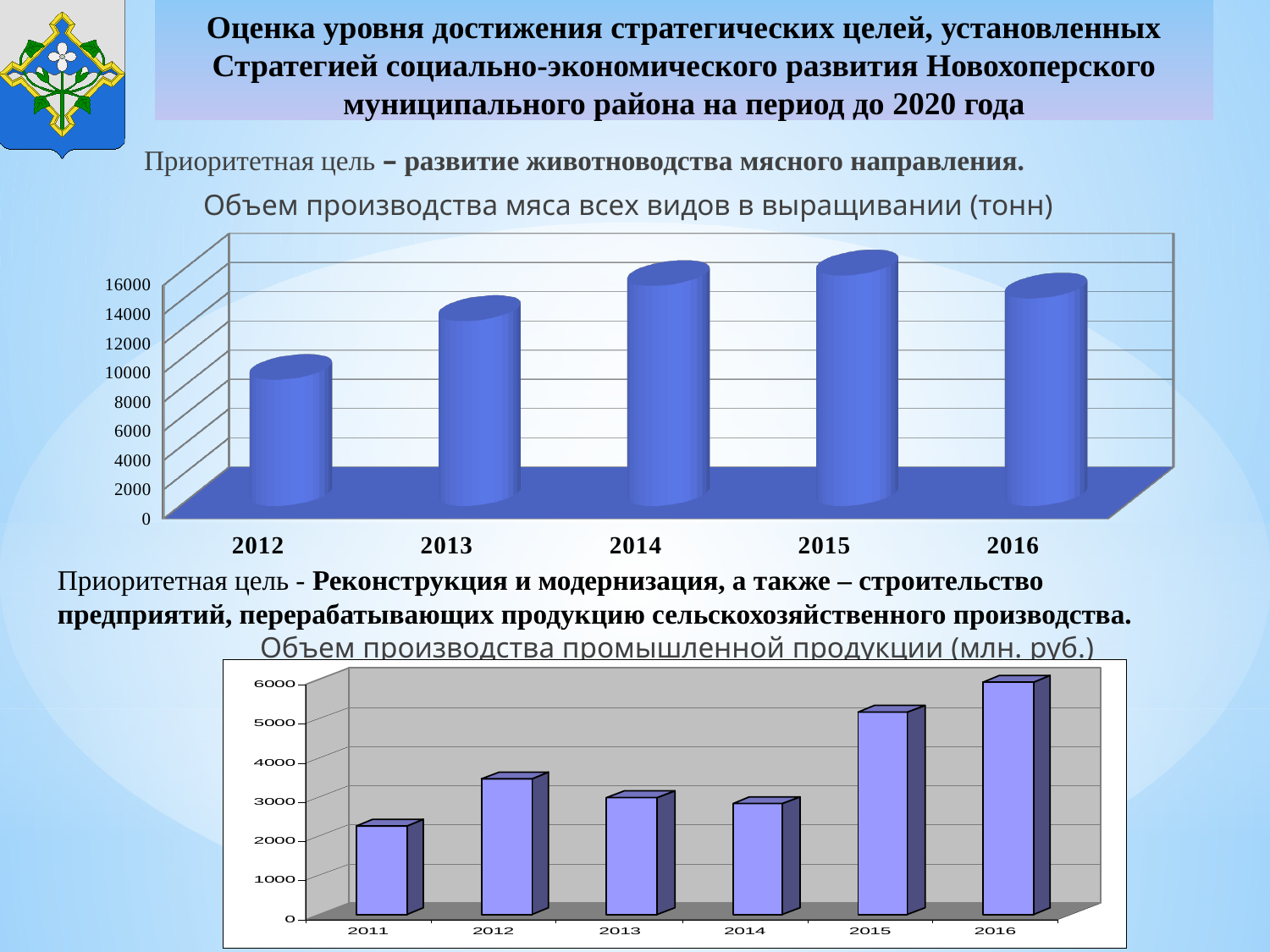
What kind of chart is the bottom chart titled "Объем производства промышленной продукции (млн. руб.)"? bar chart In the top chart (meat production), is the value for 2015 greater or less than 14000? greater In the top chart (meat production), do the values rise or fall from 2012 to 2015? rise In the chart titled "Объем производства промышленной продукции (млн. руб.)", which year has the highest value? 2016 In the chart titled "Объем производства мяса всех видов в выращивании (тонн)", which year has the highest value? 2015 In the top chart (meat production), how many years are shown on the x axis? 5 In the chart titled "Объем производства промышленной продукции (млн. руб.)", which year has the lowest value? 2011 In the bottom chart (industrial production), is the value for 2014 greater or less than 4000? less In the bottom chart (industrial production), which year has the larger value, 2012 or 2014? 2012 In the bottom chart (industrial production), is the value for 2015 greater or less than 4000? greater In the chart titled "Объем производства мяса всех видов в выращивании (тонн)", which year has the lowest value? 2012